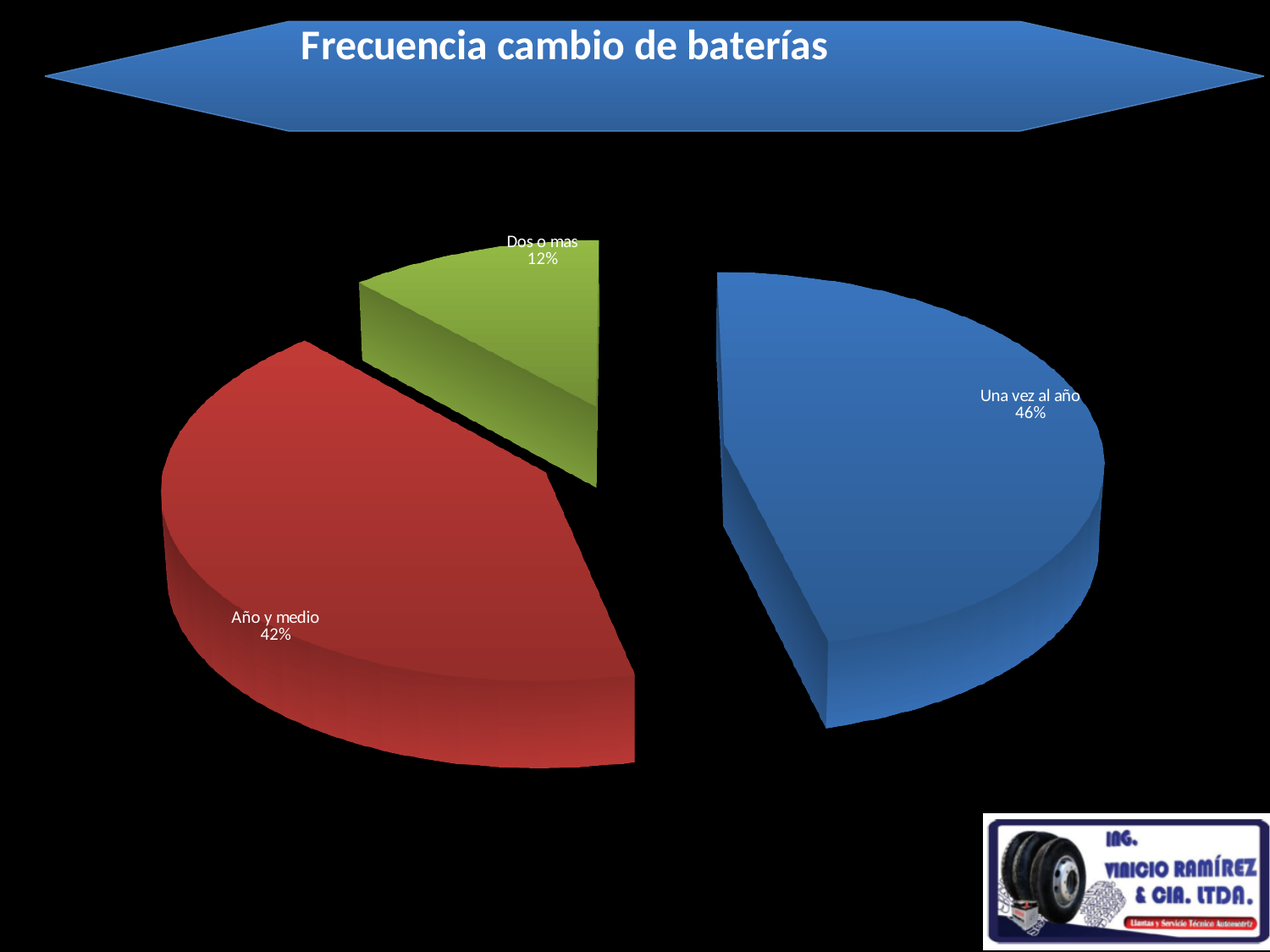
What is the difference in percentage points between "Año y medio" and "Dos o mas"? 30 What percentage of the pie is labelled "Dos o mas"? 12% Which category has the smallest share of the pie? Dos o mas What percentage of the pie is labelled "Una vez al año"? 46% What percentage of the pie is labelled "Año y medio"? 42% Which category has the largest share of the pie? Una vez al año What kind of chart is shown on the slide? Pie chart What is the title of the chart? Frecuencia cambio de baterías What colour is the slice for "Dos o mas"? Green How many slices does the pie chart have? 3 What is the difference in percentage points between "Una vez al año" and "Año y medio"? 4 Which is larger, the share for "Año y medio" or the share for "Dos o mas"? Año y medio